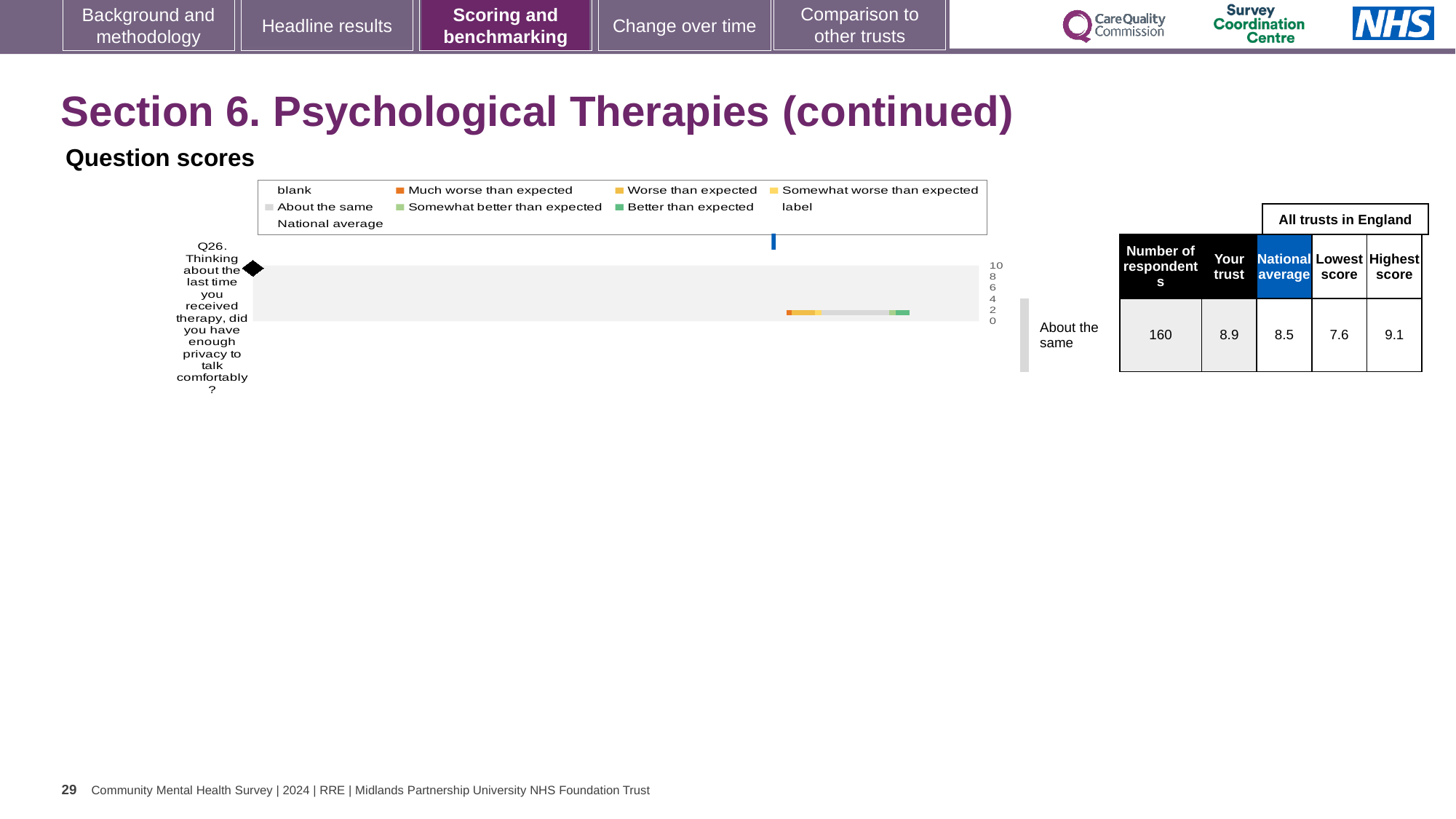
Which is larger for Q26, the 'Your trust' score or the national average? Your trust How many survey questions are plotted in the question scores chart? 1 What is the difference between the 'Your trust' score and the national average for Q26? 0.4 What is the national average score for Q26? 8.5 What benchmark category is the trust's Q26 score placed in? About the same What is the lowest score among all trusts in England for Q26? 7.6 What is the highest score among all trusts in England for Q26? 9.1 What is the 'Your trust' score for Q26 in the table next to the chart? 8.9 Which legend entry is shown in orange in the question scores chart? Much worse than expected How many respondents answered Q26? 160 What is the highest value shown on the chart's score axis? 10 What kind of chart is used to show the Q26 question score? bar chart